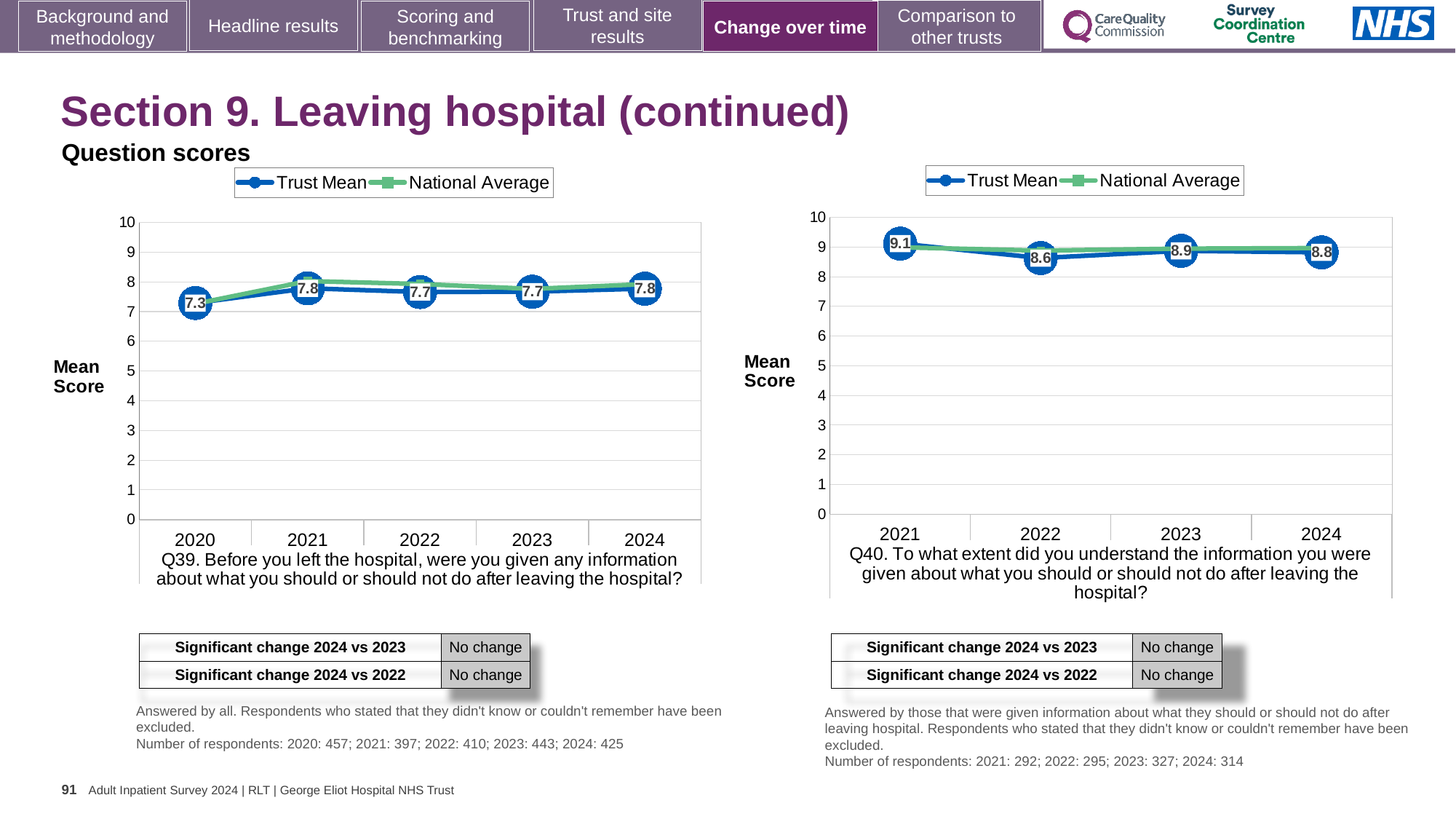
In the Q39 chart on the left, what is the difference between the Trust Mean scores for 2024 and 2020? 0.5 How many years are plotted on the x axis of the Q39 chart on the left? 5 In the Q39 chart on the left, which year has the lowest Trust Mean score? 2020 In the Q40 chart on the right, what is the Trust Mean score for 2021? 9.1 How many series does the legend of the Q40 chart on the right list? 2 What type of chart is used for the Q39 chart on the left? Line chart In the Q39 chart on the left, what is the Trust Mean score for 2024? 7.8 In the Q40 chart on the right, what is the Trust Mean score for 2022? 8.6 In the Q40 chart on the right, what is the difference between the Trust Mean scores for 2021 and 2022? 0.5 In the Q40 chart on the right, which year has the highest Trust Mean score? 2021 In the Q40 chart on the right, is the Trust Mean score for 2023 larger or smaller than the score for 2022? larger In the Q39 chart on the left, what is the Trust Mean score for 2020? 7.3